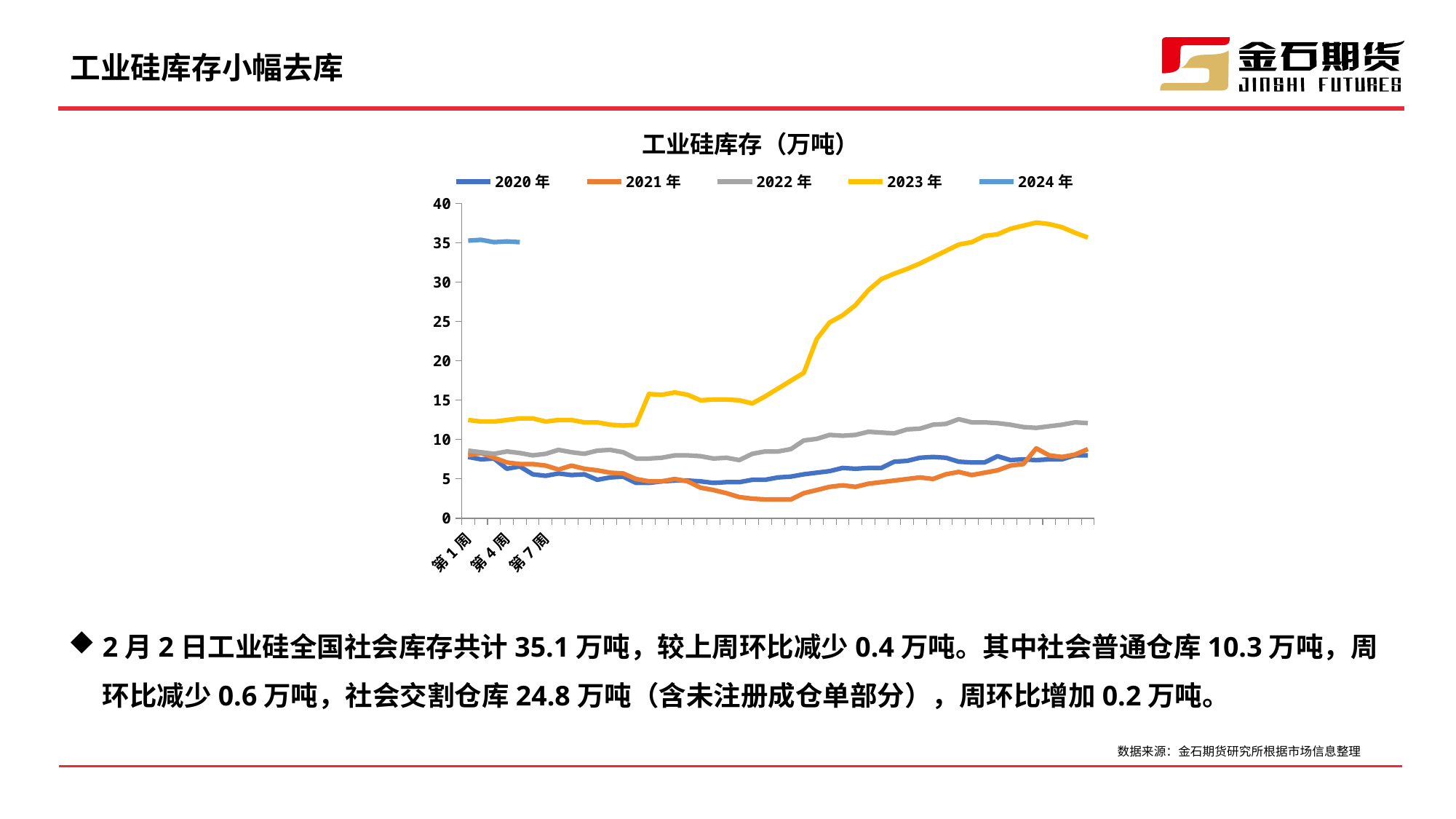
At 第1周, which series has the larger value, 2024 年 or 2023 年? 2024 年 Is the value for 2023 年 at 第1周 greater or less than 15? less What kind of chart is shown on the slide? line chart What colour is the 2023 年 line in the legend? yellow Which series reaches the highest value on the chart? 2023 年 How many series does the legend list? 5 At 第7周, which series has the larger value, 2023 年 or 2020 年? 2023 年 What is the title of the chart? 工业硅库存（万吨） Is the value for 2021 年 at 第7周 greater or less than 10? less Which series drops to the lowest value on the chart? 2021 年 Does the 2023 年 series generally rise or fall along the x axis? rise Is the value for 2024 年 at 第1周 greater or less than 30? greater